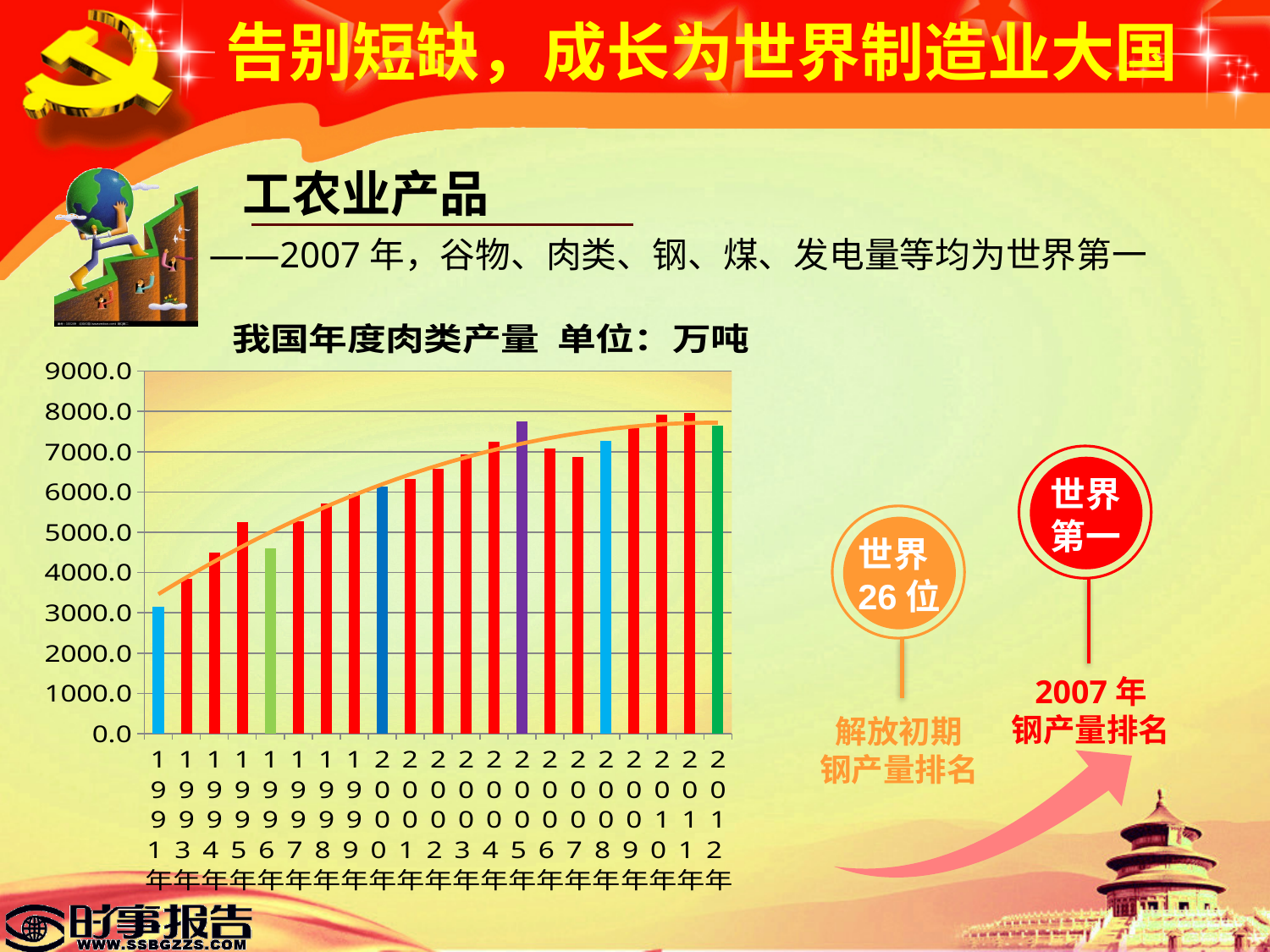
What kind of chart is used to show 我国年度肉类产量? bar chart How many years (bars) are shown in the chart? 21 Is the value for 1991年 greater or less than 4000.0? less What unit is stated in the chart title? 万吨 Which year has the lowest meat production in the chart? 1991年 What is the title of the chart? 我国年度肉类产量 单位：万吨 Is the value for 2005年 greater or less than 7000.0? greater Is the value for 2012年 greater or less than 7000.0? greater Which is larger, the value for 1991年 or the value for 2012年? 2012年 Overall, do the values rise or fall from 1991年 to 2012年? rise Which is larger, the value for 1995年 or the value for 1996年? 1995年